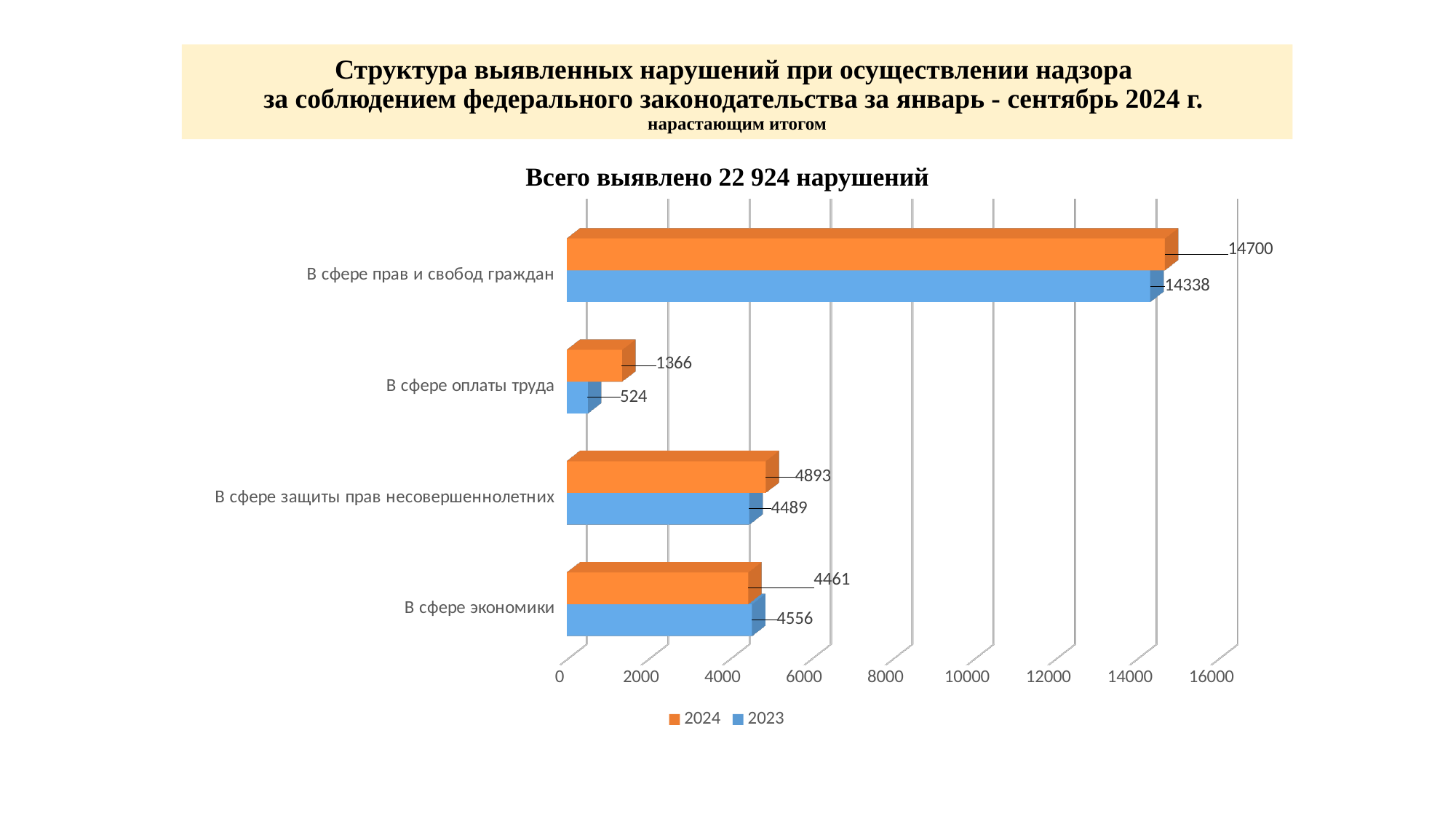
Which is larger for 'В сфере экономики': the 2024 value or the 2023 value? 2023 How many categories are shown on the chart? 4 Which category has the highest 2024 value? В сфере прав и свобод граждан How many series does the legend list? 2 What is the 2024 value for 'В сфере прав и свобод граждан'? 14700 What total number of violations is stated in the chart title? 22 924 What kind of chart is shown on the slide? Bar chart Which category has the lowest 2023 value? В сфере оплаты труда What is the 2023 value for 'В сфере оплаты труда'? 524 What is the 2024 value for 'В сфере защиты прав несовершеннолетних'? 4893 What is the 2023 value for 'В сфере экономики'? 4556 What is the difference between the 2024 and 2023 values for 'В сфере оплаты труда'? 842